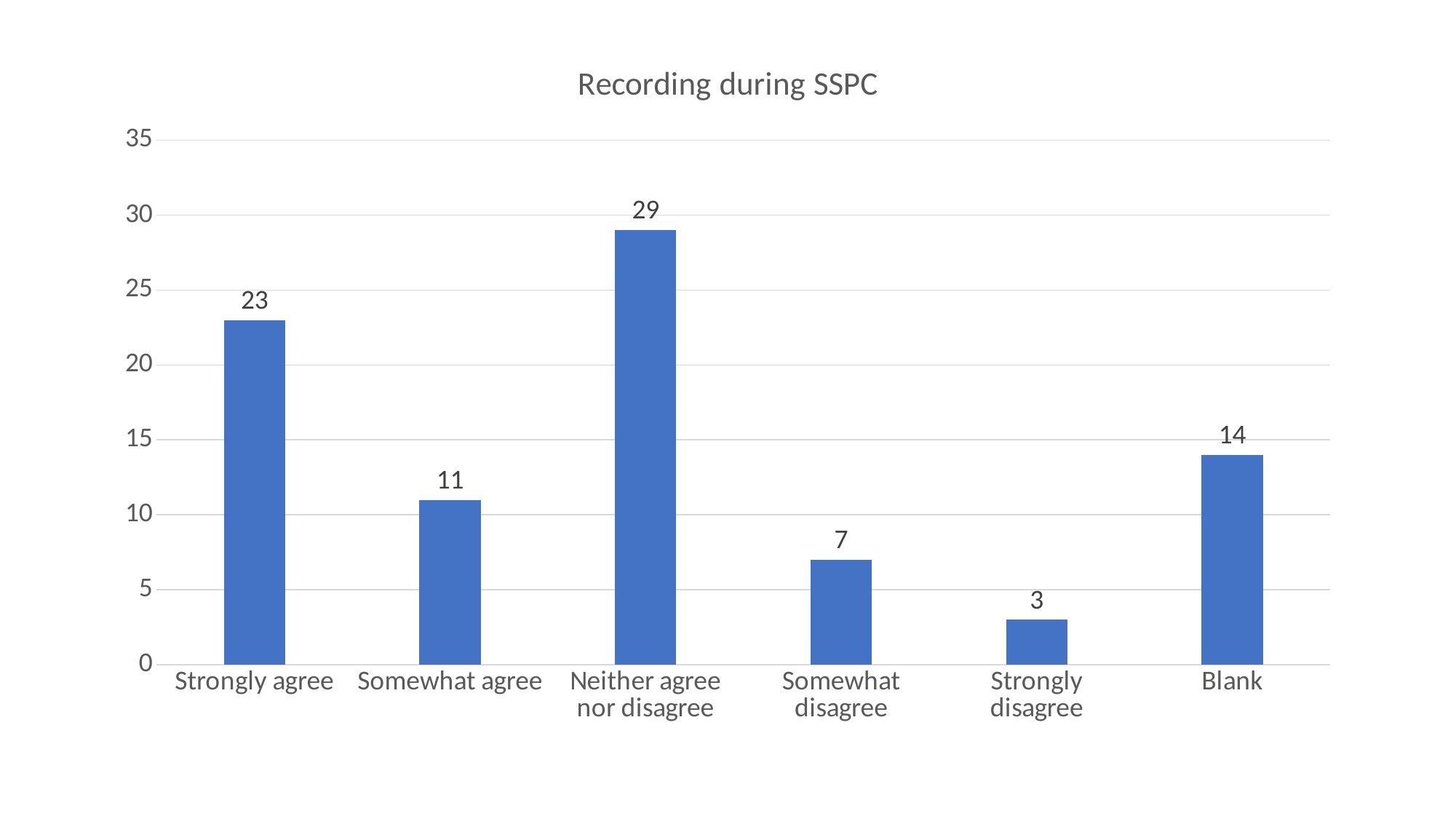
Which category has the lowest value? Strongly disagree What kind of chart is shown on the slide? bar chart What is the value for Blank? 14 Which category has the highest value? Neither agree nor disagree What is the title of the chart? Recording during SSPC What is the value for Strongly agree? 23 How many categories are shown on the x axis? 6 What is the difference between the values for Strongly agree and Somewhat agree? 12 Is the value for Somewhat agree greater or less than 10? greater What is the value for Neither agree nor disagree? 29 What is the difference between the values for Neither agree nor disagree and Strongly disagree? 26 Which is larger, the value for Somewhat disagree or the value for Blank? Blank